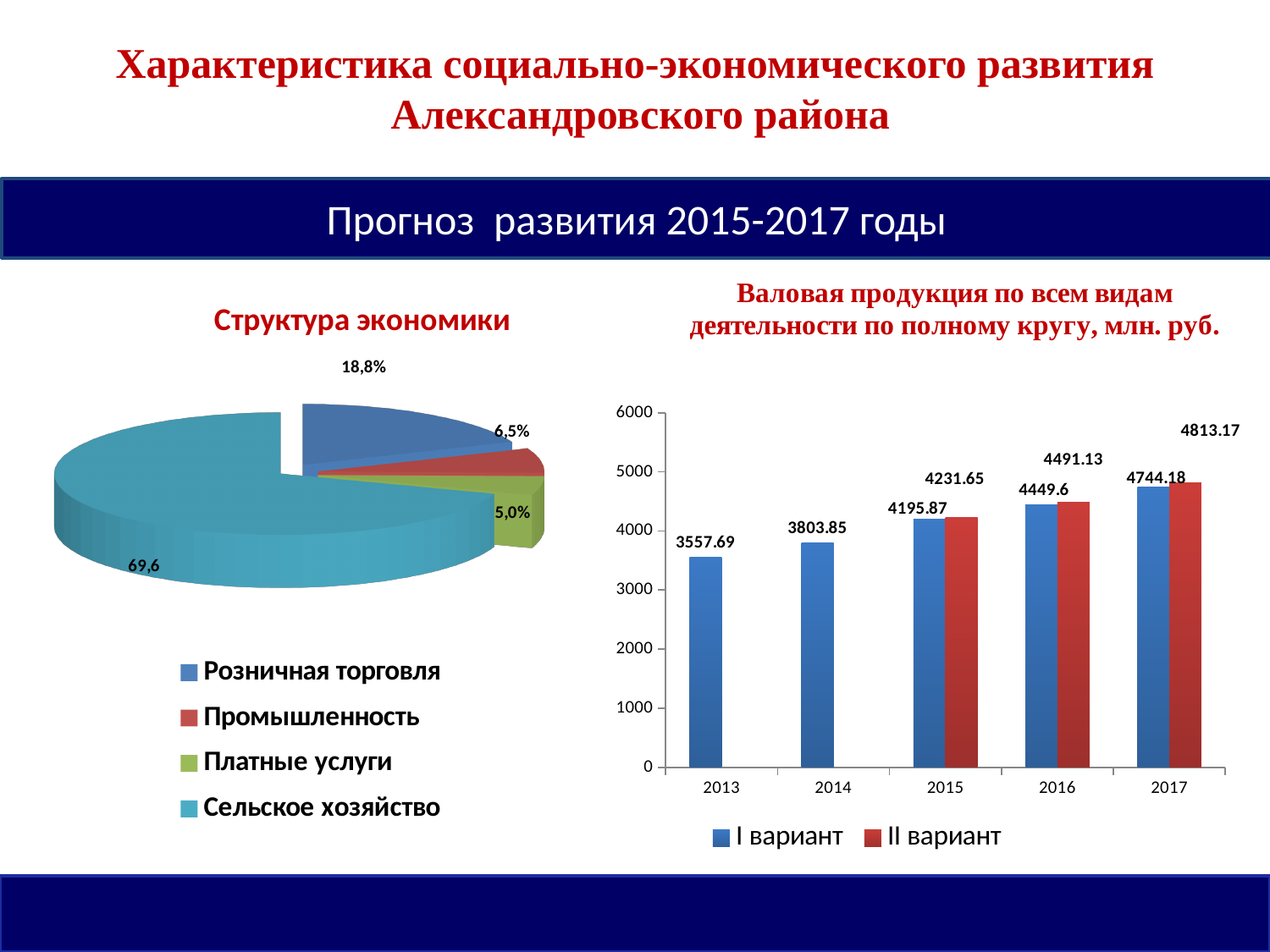
In the chart 'Валовая продукция по всем видам деятельности по полному кругу, млн. руб.', do the values of 'I вариант' rise or fall from 2013 to 2017? Rise What kind of chart is 'Валовая продукция по всем видам деятельности по полному кругу, млн. руб.'? Bar chart In the chart 'Структура экономики', which category has the smallest slice? Платные услуги In the chart 'Валовая продукция по всем видам деятельности по полному кругу, млн. руб.', how many series does the legend list? 2 In the chart 'Структура экономики', what share does 'Розничная торговля' have? 18,8% What kind of chart is 'Структура экономики'? Pie chart In the chart 'Валовая продукция по всем видам деятельности по полному кругу, млн. руб.', what is the value of 'I вариант' for 2013? 3557.69 In the chart 'Валовая продукция по всем видам деятельности по полному кругу, млн. руб.', what is the value of 'II вариант' for 2017? 4813.17 In the chart 'Валовая продукция по всем видам деятельности по полному кругу, млн. руб.', which year has the highest value for 'I вариант'? 2017 In the chart 'Структура экономики', how many categories does the legend list? 4 In the chart 'Структура экономики', what share does 'Сельское хозяйство' have? 69,6 In the chart 'Валовая продукция по всем видам деятельности по полному кругу, млн. руб.', which is larger for 2016: 'I вариант' or 'II вариант'? II вариант